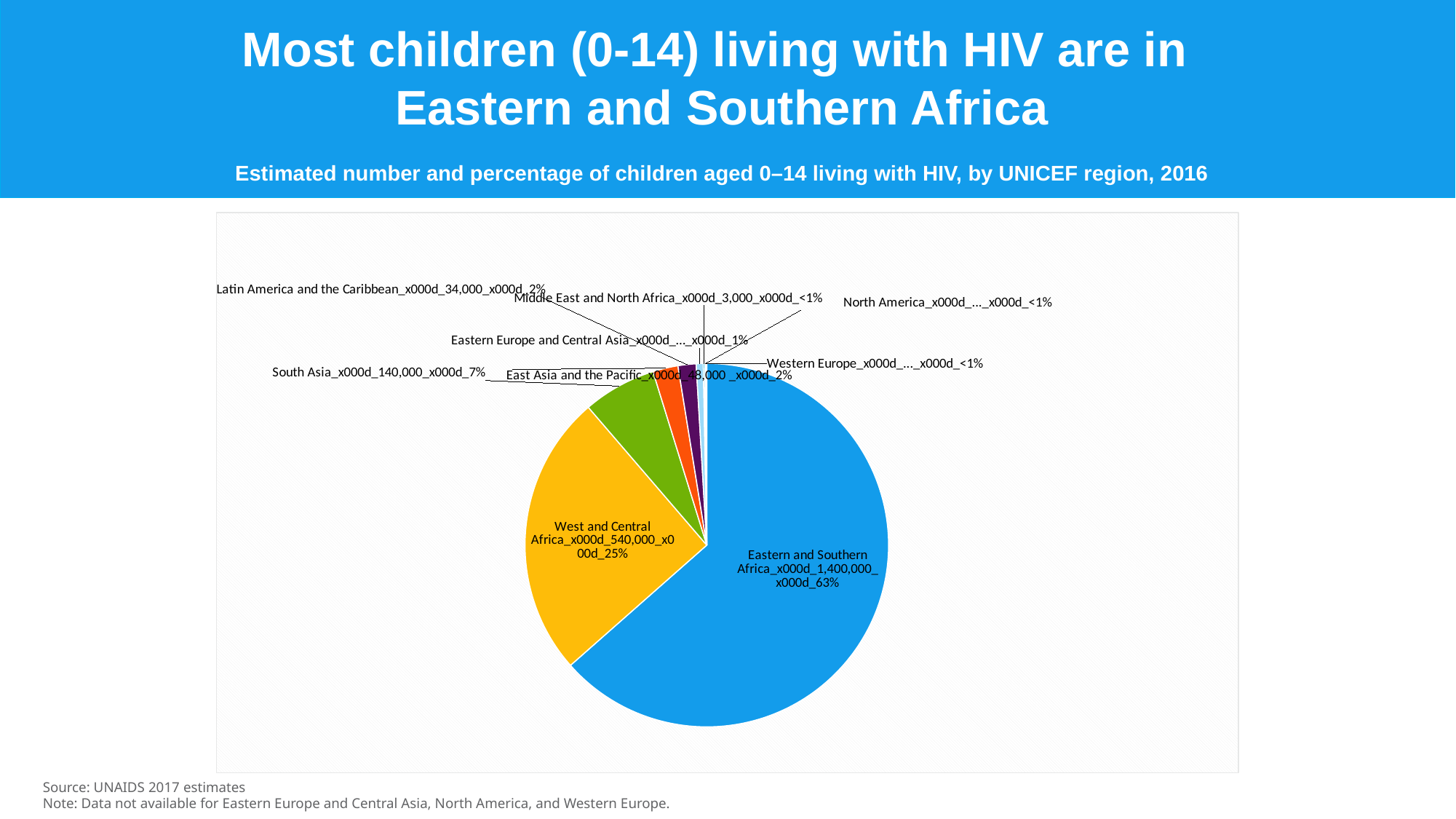
What percentage share does West and Central Africa have in the pie chart? 25% What percentage of children aged 0–14 living with HIV are in Eastern and Southern Africa? 63% Which region has the largest slice of the pie chart? Eastern and Southern Africa Which is larger, the number of children living with HIV in South Asia or in East Asia and the Pacific? South Asia What is the estimated number of children aged 0–14 living with HIV in West and Central Africa? 540,000 What is the estimated number of children aged 0–14 living with HIV in South Asia? 140,000 What is the estimated number of children aged 0–14 living with HIV in Latin America and the Caribbean? 34,000 What is the estimated number of children aged 0–14 living with HIV in the Middle East and North Africa? 3,000 What is the difference between the number of children living with HIV in Eastern and Southern Africa and in West and Central Africa? 860,000 What kind of chart is shown on the slide? pie chart What is the estimated number of children aged 0–14 living with HIV in East Asia and the Pacific? 48,000 What is the estimated number of children aged 0–14 living with HIV in Eastern and Southern Africa? 1,400,000